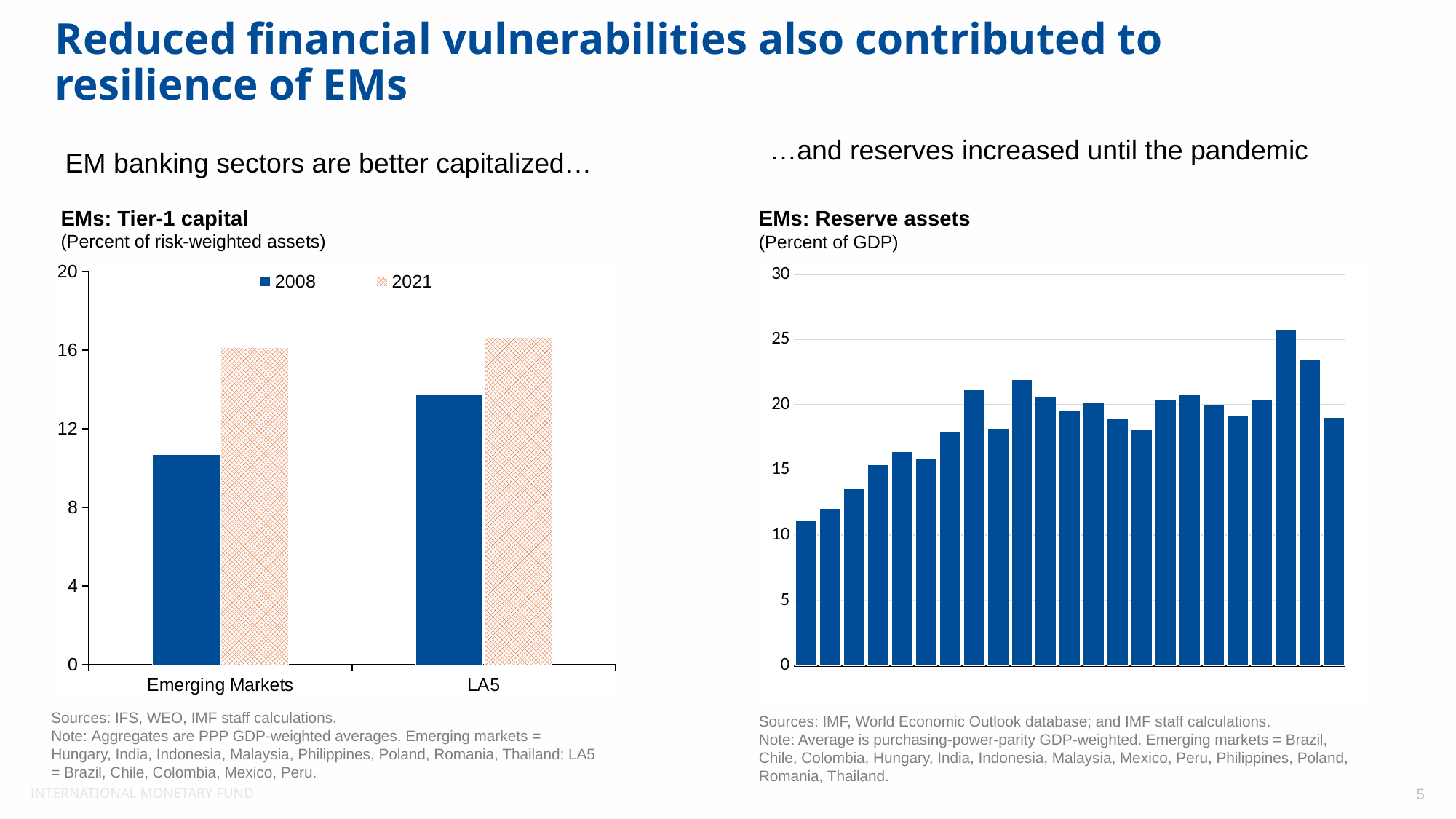
In the 'EMs: Tier-1 capital' chart, is the 2008 value for Emerging Markets greater or less than 12? less What kind of chart is the 'EMs: Reserve assets' chart on the right? bar chart In the 'EMs: Tier-1 capital' chart, how many categories are shown on the x axis? 2 In the 'EMs: Tier-1 capital' chart, is the 2008 value for LA5 greater or less than 12? greater What kind of chart is the 'EMs: Tier-1 capital' chart on the left? bar chart In the 'EMs: Reserve assets' chart, is the tallest bar greater or less than 25? greater In the 'EMs: Reserve assets' chart, what unit is given in the subtitle? Percent of GDP In the 'EMs: Tier-1 capital' chart, how many series does the legend list? 2 In the 'EMs: Tier-1 capital' chart, which years are listed in the legend? 2008 and 2021 In the 'EMs: Tier-1 capital' chart, which is larger for Emerging Markets, the 2008 value or the 2021 value? 2021 In the 'EMs: Tier-1 capital' chart, which category has the higher 2008 value, Emerging Markets or LA5? LA5